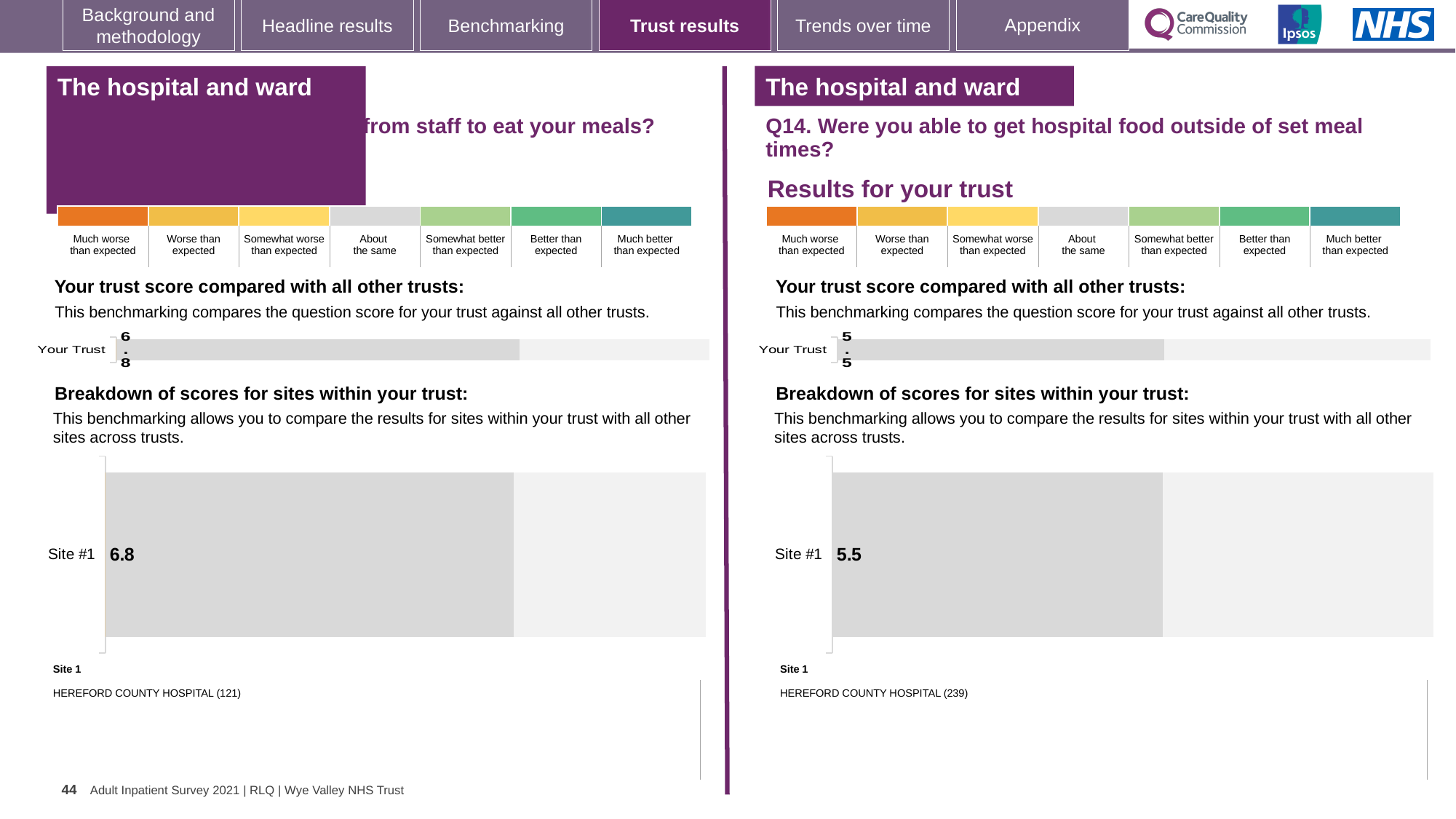
What kind of chart is used to show the Site #1 score in the right-hand (Q14) breakdown section? Bar chart In the left-hand breakdown chart, which hospital is listed as Site 1? HEREFORD COUNTY HOSPITAL (121) In the right-hand (Q14) breakdown chart, which hospital is listed as Site 1? HEREFORD COUNTY HOSPITAL (239) What is the difference between the Your Trust score on the left-hand side (6.8) and the Your Trust score on the right-hand side (5.5)? 1.3 On the right-hand side of the slide (Q14), what score is shown for Site #1 in the 'Breakdown of scores for sites within your trust' chart? 5.5 On the right-hand side of the slide (Q14), what is the score shown for Your Trust in the 'Your trust score compared with all other trusts' chart? 5.5 On the left-hand side of the slide, what is the score shown for Your Trust in the 'Your trust score compared with all other trusts' chart? 6.8 On the left-hand side of the slide, what score is shown for Site #1 in the 'Breakdown of scores for sites within your trust' chart? 6.8 Is the Your Trust score in the right-hand (Q14) chart greater or less than 6? less Which is larger: the Site #1 score in the left-hand breakdown chart or the Site #1 score in the right-hand (Q14) breakdown chart? Left-hand chart (6.8) How many sites are shown in the 'Breakdown of scores for sites within your trust' chart on the right-hand side (Q14)? 1